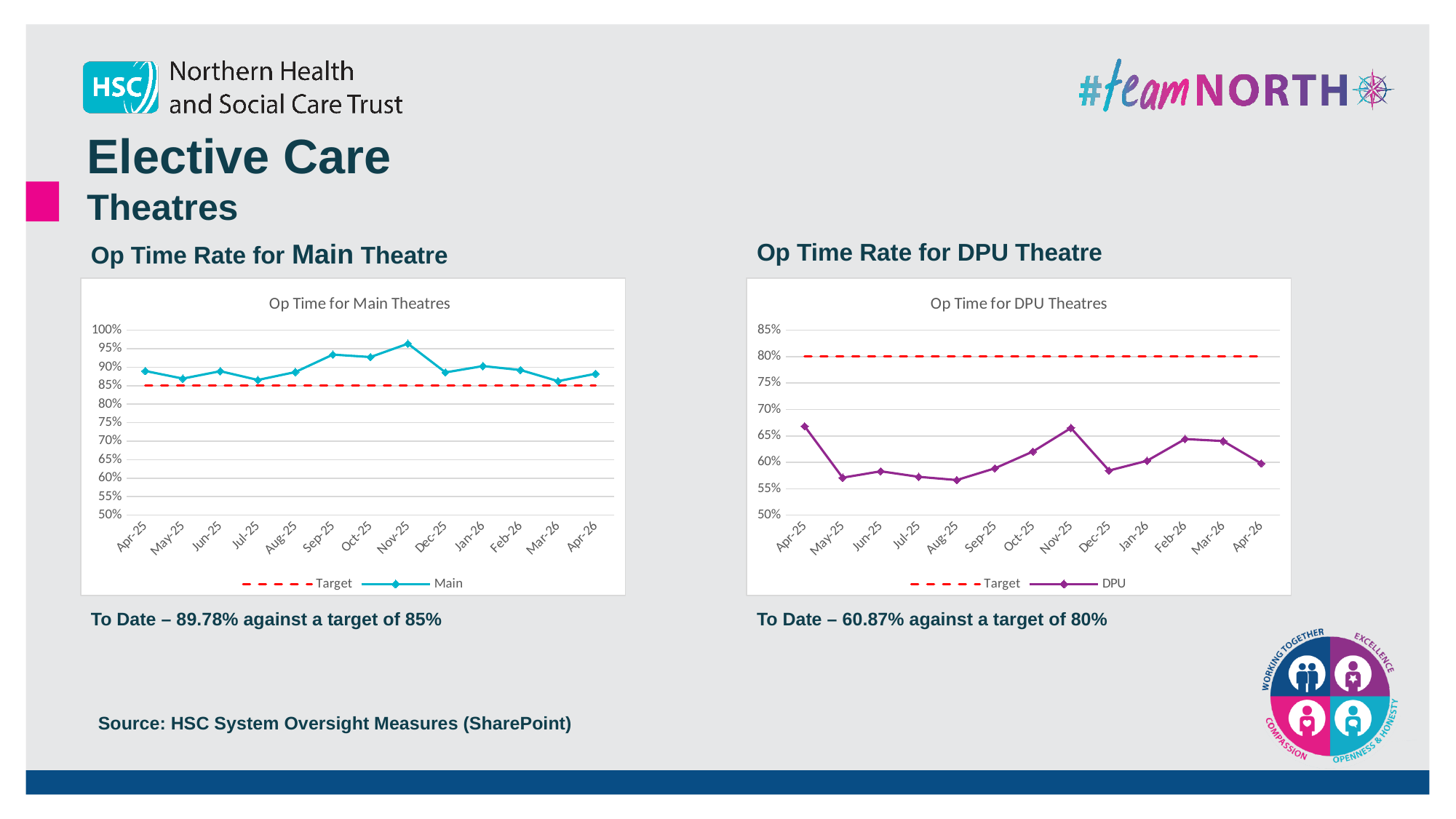
In the 'Op Time for Main Theatres' chart, which month has the highest Main value? Nov-25 In the 'Op Time for DPU Theatres' chart, what are the two legend entries? Target and DPU In the 'Op Time for Main Theatres' chart, what value does the dashed Target line sit at? 85% What kind of chart is the 'Op Time for Main Theatres' chart? line chart In the 'Op Time for DPU Theatres' chart, does the DPU line fall or rise from Apr-25 to May-25? fall In the 'Op Time for Main Theatres' chart, how many months are plotted on the x axis? 13 In the 'Op Time for DPU Theatres' chart, is the DPU value for Aug-25 greater or less than 60%? less In the 'Op Time for DPU Theatres' chart, which is larger, the DPU value for Nov-25 or for Dec-25? Nov-25 In the 'Op Time for DPU Theatres' chart, what value does the dashed Target line sit at? 80% In the 'Op Time for Main Theatres' chart, is the Main value for Sep-25 greater or less than 90%? greater In the 'Op Time for Main Theatres' chart, how many series does the legend list? 2 In the 'Op Time for Main Theatres' chart, which is larger, the Main value for Nov-25 or for Jul-25? Nov-25